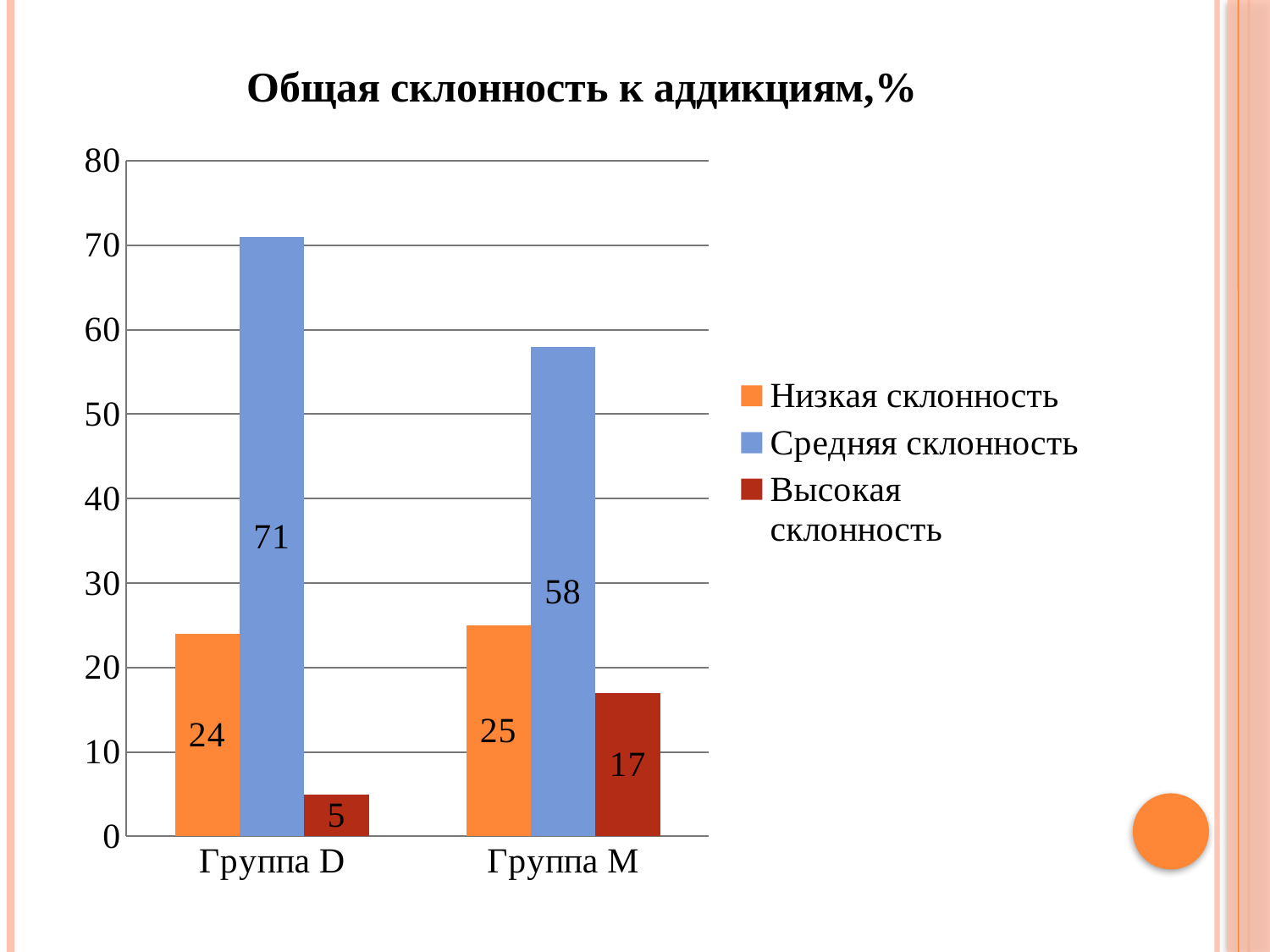
What is the value for Средняя склонность in Группа D? 71 What is the value for Низкая склонность in Группа M? 25 What is the difference between Высокая склонность in Группа M and in Группа D? 12 Which group has the highest value for Средняя склонность? Группа D What kind of chart is shown on the slide? Bar chart How many groups are shown on the x axis? 2 What is the difference between Средняя склонность in Группа D and in Группа M? 13 Which series has the lowest value in Группа D? Высокая склонность What is the value for Высокая склонность in Группа D? 5 How many series does the legend list? 3 Which is larger: Низкая склонность in Группа D or Высокая склонность in Группа M? Низкая склонность in Группа D What is the value for Высокая склонность in Группа M? 17